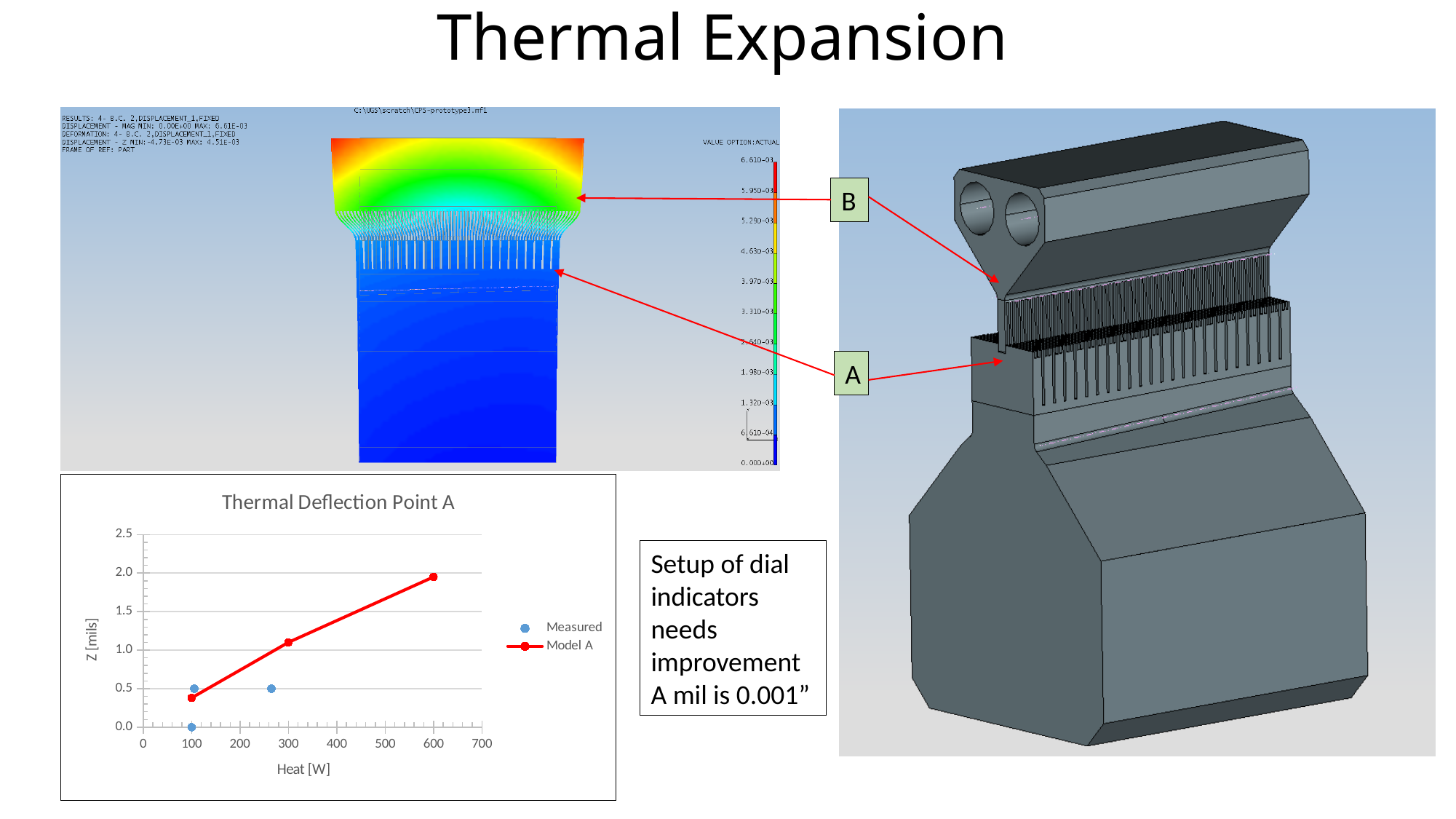
In the Thermal Deflection Point A chart, at which Heat value does the Model A series have its lowest Z value? 100 W In the Thermal Deflection Point A chart, which is larger: the Model A value at 600 W or the Model A value at 300 W? Model A at 600 W What are the two series named in the legend of the Thermal Deflection Point A chart? Measured and Model A In the Thermal Deflection Point A chart, is the Model A value at 300 W greater or less than 0.5 mils? greater What is the title of the chart on the slide? Thermal Deflection Point A In the Thermal Deflection Point A chart, is the Model A value at 600 W greater or less than 1.5 mils? greater What kind of chart is the Thermal Deflection Point A chart? Line chart with scatter points In the Thermal Deflection Point A chart, does the Model A series rise or fall as Heat increases? Rises In the Thermal Deflection Point A chart, at which Heat value does the Model A series reach its highest Z value? 600 W How many series does the legend of the Thermal Deflection Point A chart list? 2 How many data points does the Model A series have in the Thermal Deflection Point A chart? 3 In the Thermal Deflection Point A chart, is the Model A value at 100 W greater or less than 1.0 mils? less